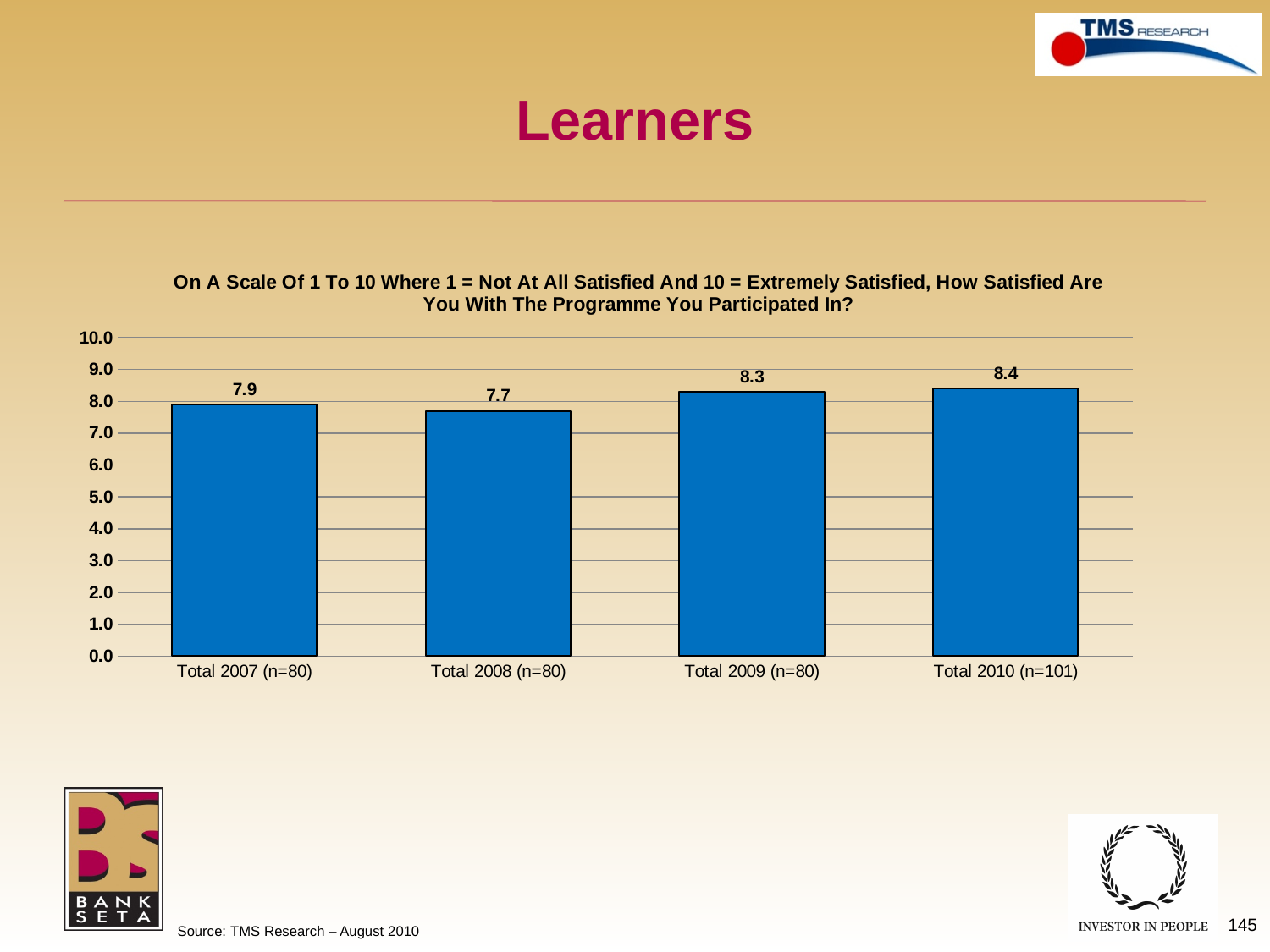
Which category has the lowest satisfaction score? Total 2008 (n=80) What kind of chart is shown on the slide? Bar chart How many categories are shown on the chart? 4 Is the value for Total 2008 (n=80) greater or less than 8.0? less Which is larger, the score for Total 2007 (n=80) or Total 2009 (n=80)? Total 2009 (n=80) Which category has the highest satisfaction score? Total 2010 (n=101) What is the maximum value shown on the vertical axis? 10.0 What is the difference between the satisfaction scores for Total 2010 (n=101) and Total 2008 (n=80)? 0.7 What is the satisfaction score for Total 2007 (n=80)? 7.9 What is the satisfaction score for Total 2009 (n=80)? 8.3 What is the satisfaction score for Total 2010 (n=101)? 8.4 What is the satisfaction score for Total 2008 (n=80)? 7.7